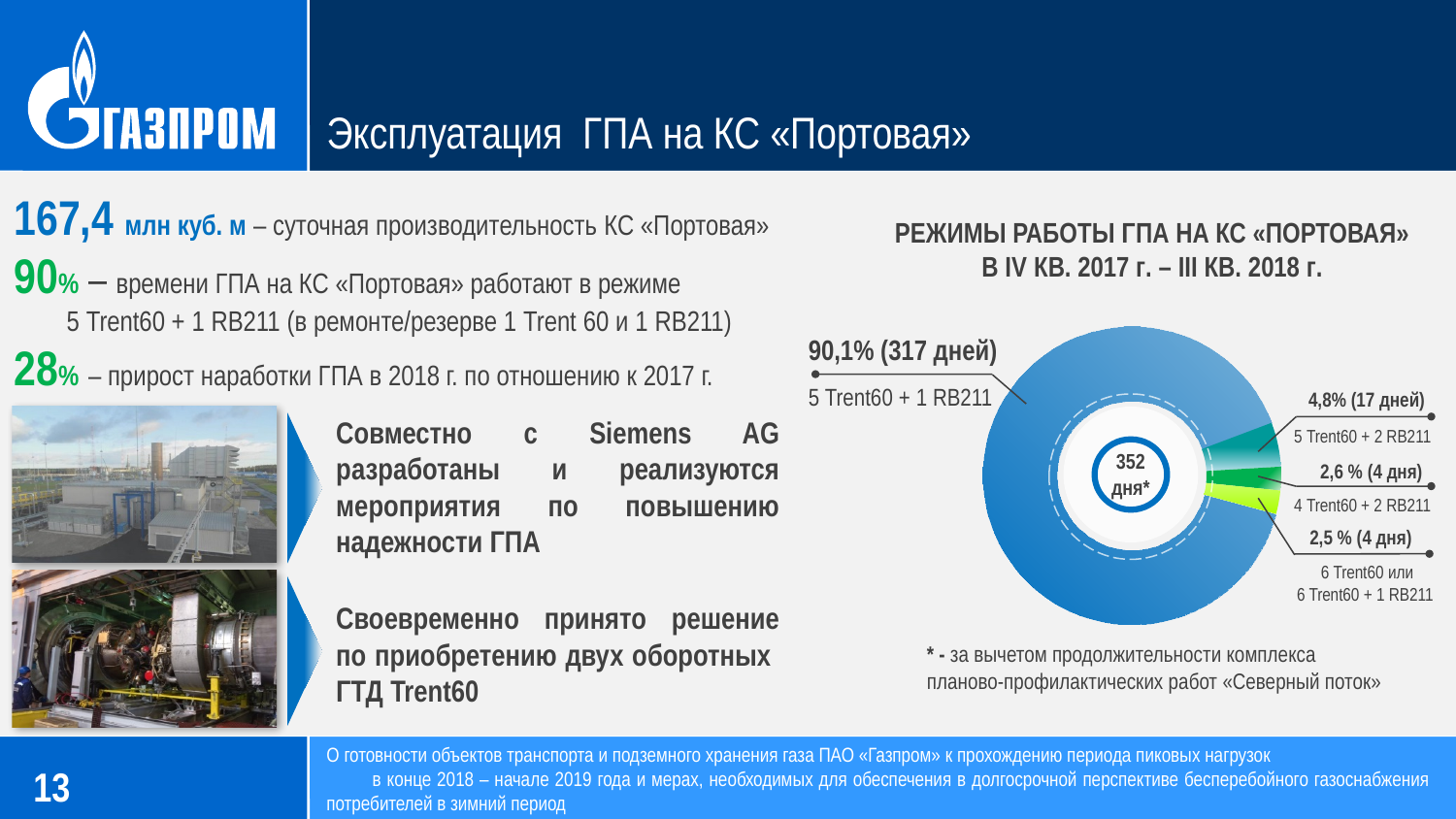
Which mode has a larger share: 5 Trent60 + 2 RB211 or 4 Trent60 + 2 RB211? 5 Trent60 + 2 RB211 How many operating modes (slices) are shown in the chart? 4 By how many days does the mode 5 Trent60 + 1 RB211 exceed the mode 5 Trent60 + 2 RB211? 300 дней What share of time did the GPA at KS «Портовая» operate in the mode 5 Trent60 + 1 RB211? 90,1% Which operating mode has the smallest share in the chart? 6 Trent60 или 6 Trent60 + 1 RB211 Which operating mode has the largest share in the chart? 5 Trent60 + 1 RB211 What share of time corresponds to the mode 6 Trent60 или 6 Trent60 + 1 RB211? 2,5 % How many days correspond to the mode 5 Trent60 + 1 RB211? 317 дней What kind of chart is shown on the slide? Doughnut (pie) chart How many days correspond to the mode 4 Trent60 + 2 RB211? 4 дня What share of time corresponds to the mode 5 Trent60 + 2 RB211? 4,8% What value is shown in the centre of the doughnut chart? 352 дня*